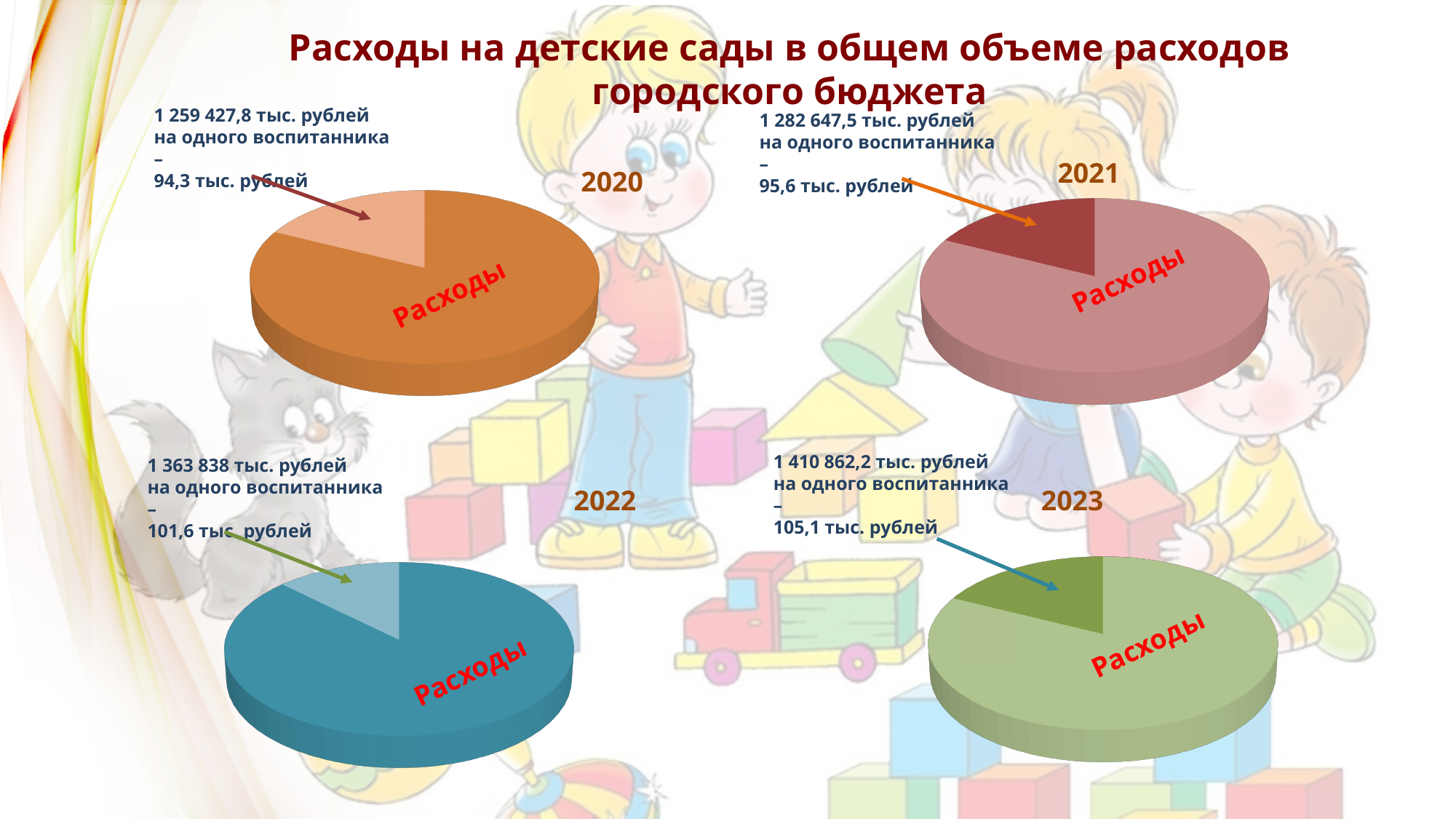
Does the expenditure per pupil rise or fall from the 2020 chart to the 2023 chart? Rise In the 2022 chart, what is the expenditure per pupil (на одного воспитанника)? 101,6 тыс. рублей What is the difference in expenditure per pupil between the 2023 chart and the 2020 chart? 10,8 тыс. рублей In the 2023 chart, what total amount of kindergarten expenditure is indicated for the highlighted slice? 1 410 862,2 тыс. рублей In the 2023 chart, what is the expenditure per pupil (на одного воспитанника)? 105,1 тыс. рублей Which year's chart shows the highest expenditure per pupil? 2023 In the 2020 chart, what total amount of kindergarten expenditure is indicated for the highlighted slice? 1 259 427,8 тыс. рублей How many pie charts are shown on the slide? 4 In the 2020 chart, what is the expenditure per pupil (на одного воспитанника)? 94,3 тыс. рублей What kind of chart is used for each year on the slide? Pie chart In the 2021 chart, what total amount of kindergarten expenditure is indicated for the highlighted slice? 1 282 647,5 тыс. рублей Which year's chart shows the lowest total kindergarten expenditure? 2020